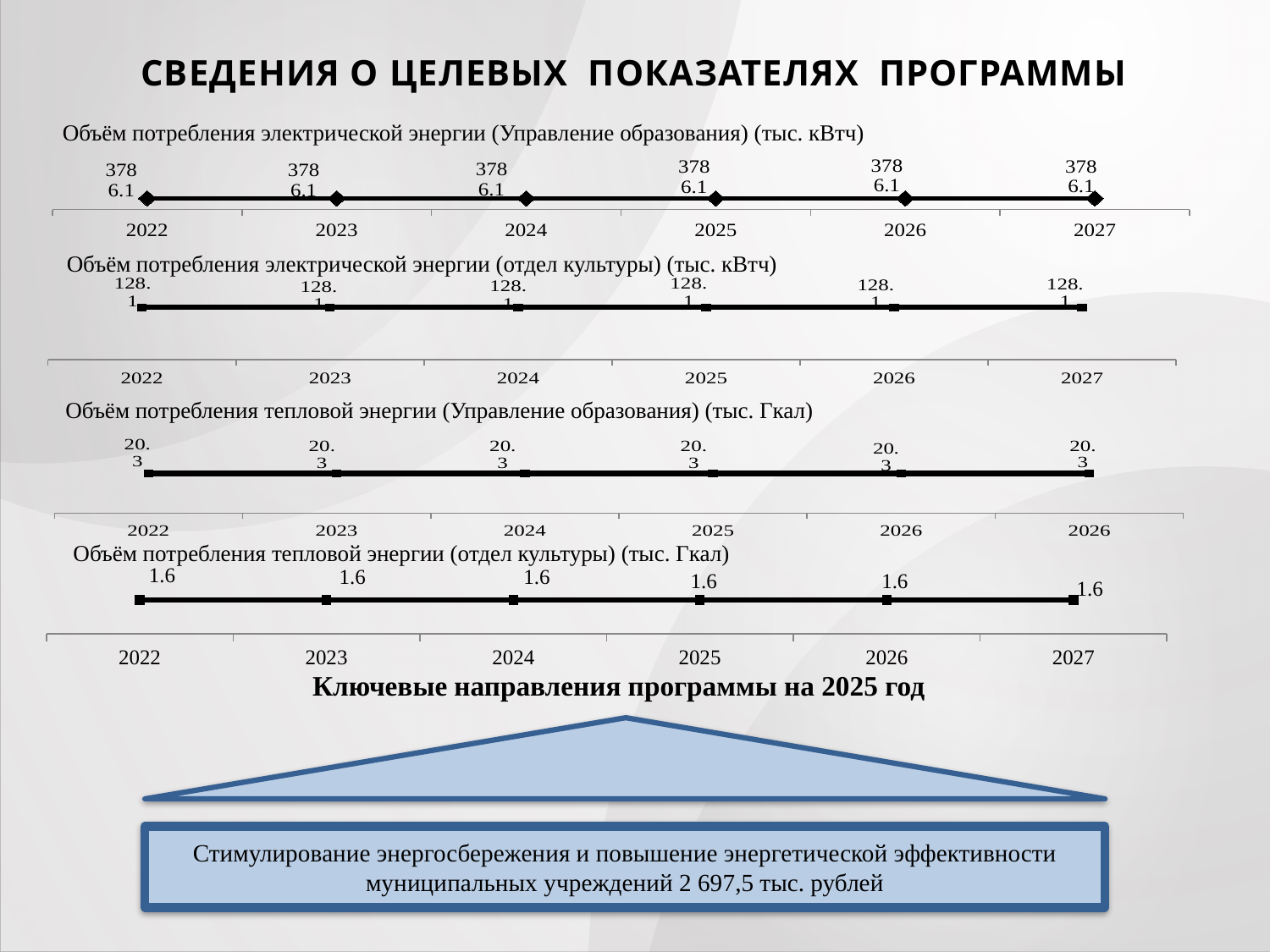
On the chart 'Объём потребления тепловой энергии (отдел культуры) (тыс. Гкал)', how many years are plotted? 6 On the chart 'Объём потребления тепловой энергии (отдел культуры) (тыс. Гкал)', do the values rise, fall or stay the same from 2022 to 2027? Stay the same On the chart 'Объём потребления электрической энергии (Управление образования) (тыс. кВтч)', do the values rise, fall or stay the same across the years? Stay the same On the chart 'Объём потребления тепловой энергии (отдел культуры) (тыс. Гкал)', what is the difference between the values for 2027 and 2022? 0 On the chart 'Объём потребления тепловой энергии (отдел культуры) (тыс. Гкал)', what is the value for 2025? 1.6 On the chart 'Объём потребления тепловой энергии (Управление образования) (тыс. Гкал)', do the values rise, fall or stay the same along the x axis? Stay the same On the chart 'Объём потребления электрической энергии (Управление образования) (тыс. кВтч)', how many data points are plotted? 6 What kind of chart is 'Объём потребления электрической энергии (Управление образования) (тыс. кВтч)'? Line chart On the chart 'Объём потребления электрической энергии (отдел культуры) (тыс. кВтч)', what is the value for 2024? 128.1 On the chart 'Объём потребления тепловой энергии (отдел культуры) (тыс. Гкал)', what is the value for 2022? 1.6 On the chart 'Объём потребления тепловой энергии (Управление образования) (тыс. Гкал)', what is the value for 2023? 20.3 How many charts are shown on the slide? 4